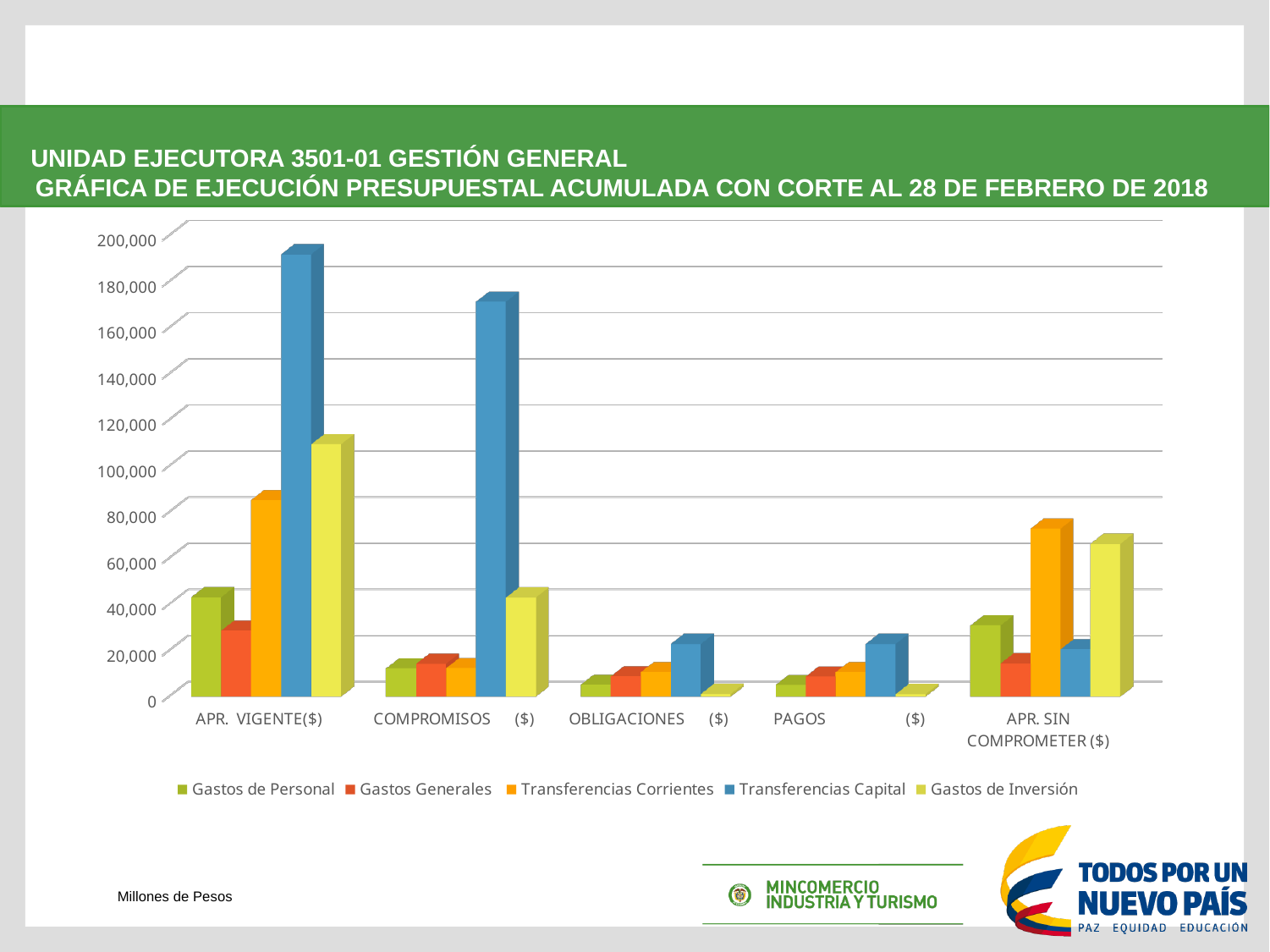
What colour represents Transferencias Capital in the chart's legend? Blue What unit is stated for the chart's values at the bottom left of the slide? Millones de Pesos Is the value for Transferencias Capital in COMPROMISOS ($) greater or less than 160,000? greater What kind of chart is shown on the slide? Bar chart Is the value for Transferencias Capital in APR. VIGENTE($) greater or less than 180,000? greater How many series does the chart's legend list? 5 How many categories are shown along the x axis of the chart? 5 In APR. VIGENTE($), which is larger: Transferencias Corrientes or Gastos de Inversión? Gastos de Inversión Is the value for Gastos de Inversión in APR. VIGENTE($) greater or less than 100,000? greater In which category is the Transferencias Capital bar the highest? APR. VIGENTE($) Which series has the lowest bar in the OBLIGACIONES ($) category? Gastos de Inversión In APR. SIN COMPROMETER ($), which is larger: Transferencias Corrientes or Transferencias Capital? Transferencias Corrientes